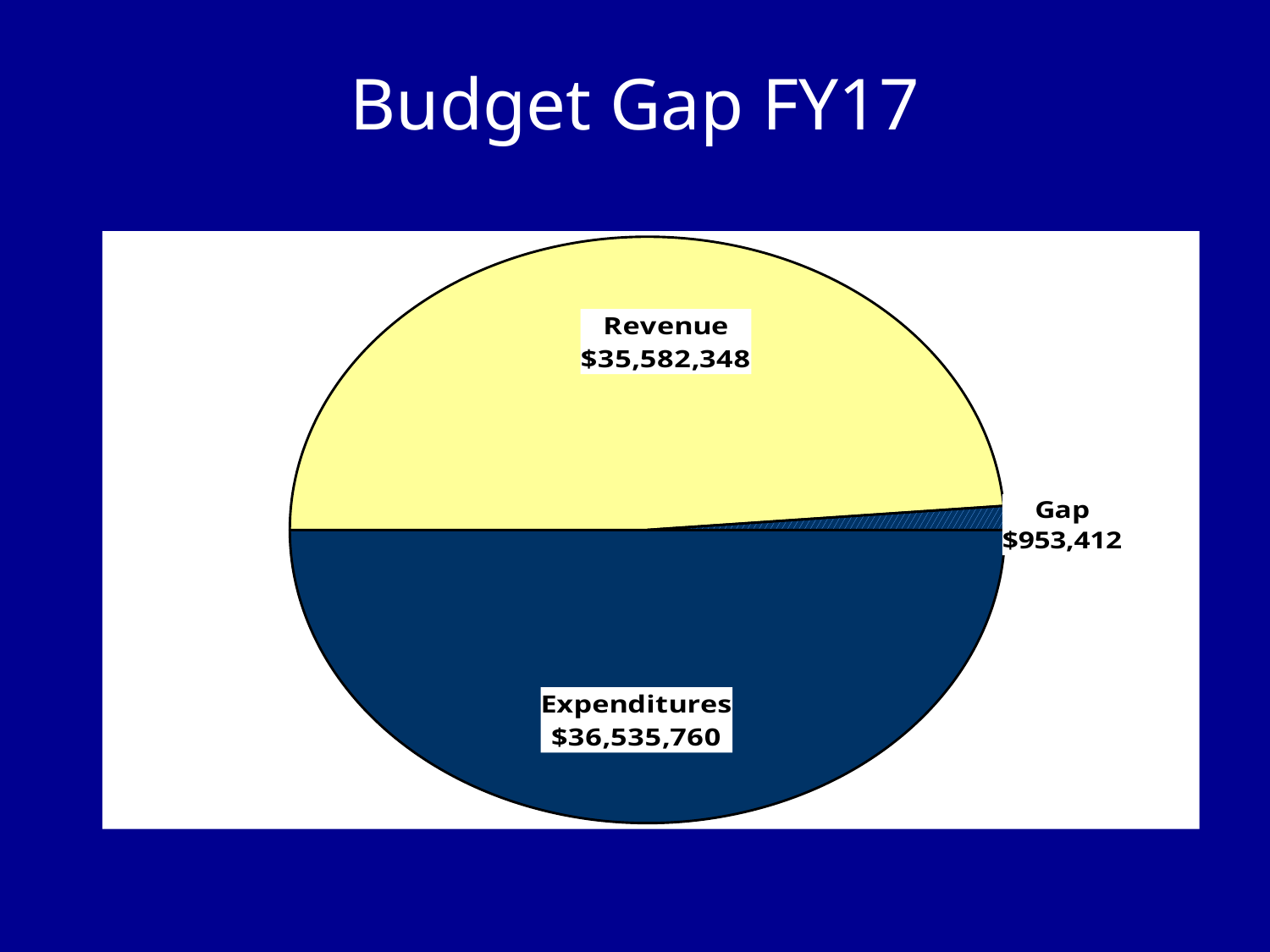
What is the value of the Gap slice? $953,412 Which slice of the pie is the largest? Expenditures How many slices does the pie chart have? 3 What is the difference between Expenditures and Revenue? $953,412 Which slice of the pie is the smallest? Gap What kind of chart is shown on the slide? Pie chart What colour is the Revenue slice? Light yellow What is the difference between Revenue and the Gap? $34,628,936 Which is larger, Revenue or Expenditures? Expenditures What is the value of the Expenditures slice? $36,535,760 What is the title of the slide? Budget Gap FY17 What is the value of the Revenue slice? $35,582,348